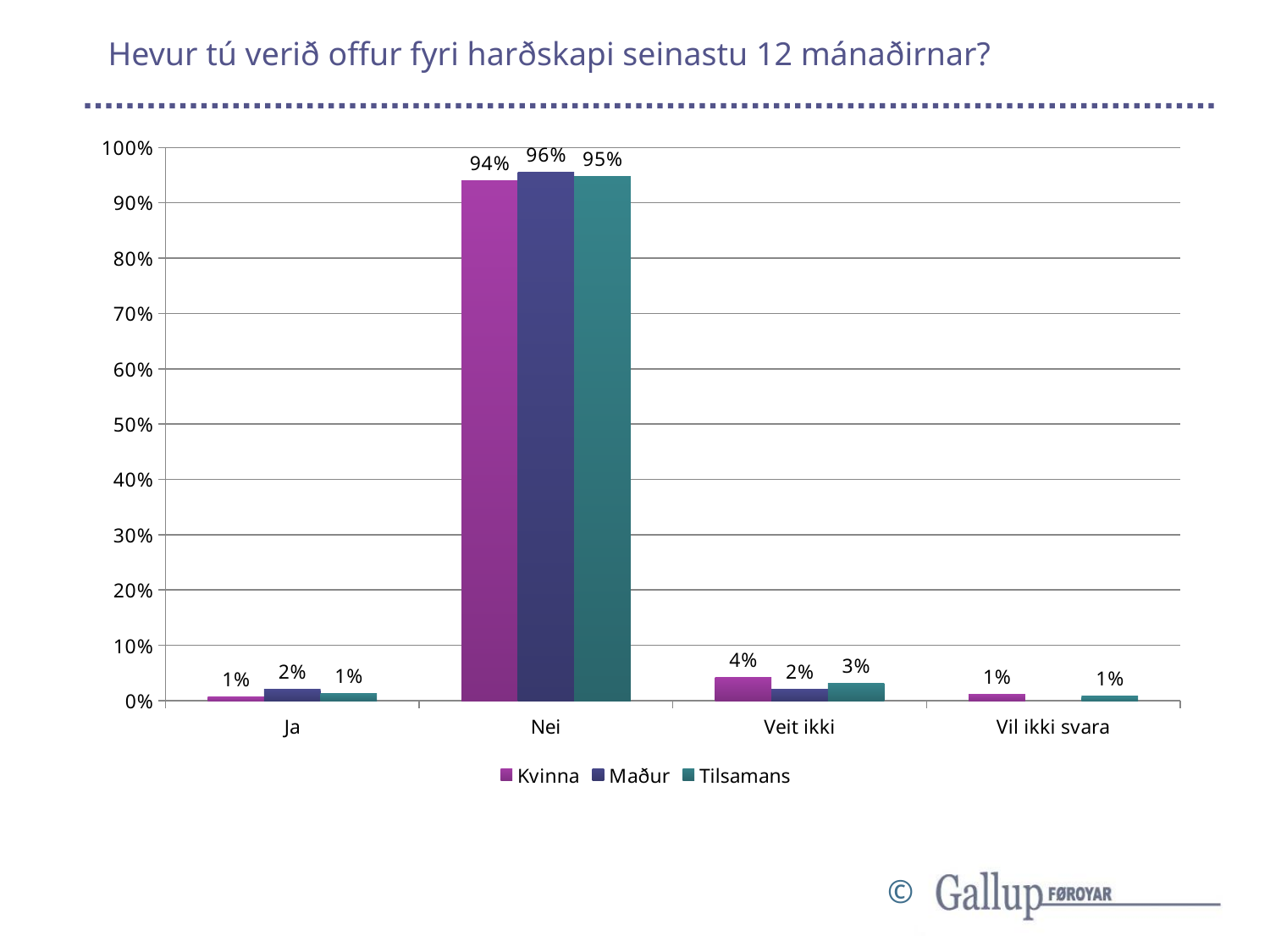
What is the difference between the Maður and Kvinna values in the Nei category? 2% How many series does the legend list? 3 Is the value for Tilsamans in the Nei category greater or less than 90%? greater What is the value for Kvinna in the Veit ikki category? 4% What is the value for Maður in the Nei category? 96% Which category has the highest value for Tilsamans? Nei What is the value for Kvinna in the Nei category? 94% How many categories are shown on the x axis? 4 In the Veit ikki category, which is larger: the Kvinna value or the Maður value? Kvinna What is the title of the chart? Hevur tú verið offur fyri harðskapi seinastu 12 mánaðirnar? What kind of chart is shown on the slide? Bar chart What is the value for Tilsamans in the Veit ikki category? 3%